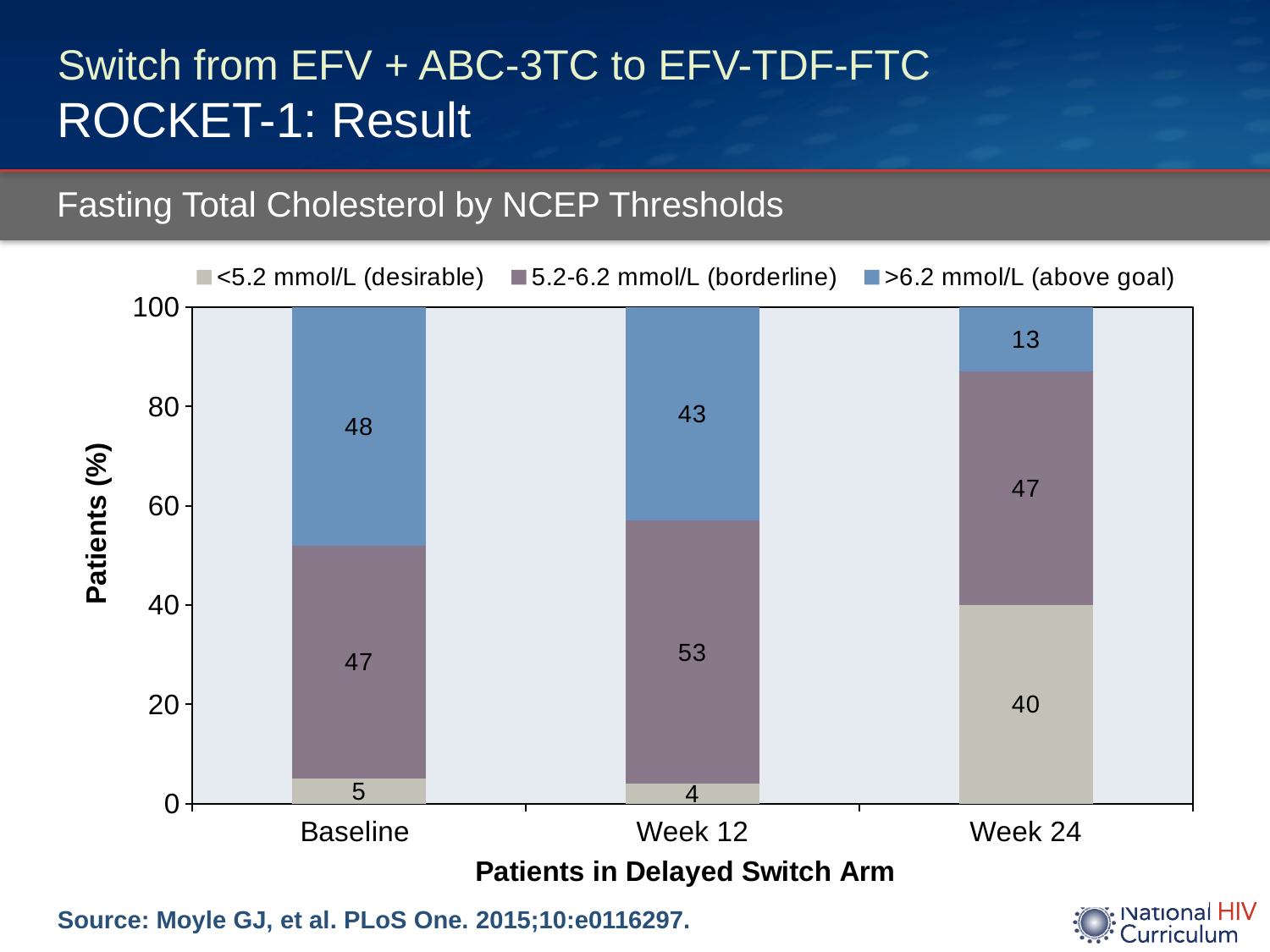
What is the label of the y axis? Patients (%) What kind of chart is shown? Stacked bar chart How many series does the legend list? 3 Does the >6.2 mmol/L (above goal) share rise or fall from Baseline to Week 24? Fall What percentage of patients had total cholesterol <5.2 mmol/L (desirable) at Week 24? 40 At which time point is the >6.2 mmol/L (above goal) share lowest? Week 24 Which is larger: the <5.2 mmol/L (desirable) share at Baseline or at Week 12? Baseline At which time point is the <5.2 mmol/L (desirable) share highest? Week 24 How many time points are shown on the x axis? 3 What percentage of patients had total cholesterol >6.2 mmol/L (above goal) at Baseline? 48 By how many percentage points did the >6.2 mmol/L (above goal) share fall from Baseline to Week 24? 35 What percentage of patients were in the 5.2-6.2 mmol/L (borderline) category at Week 12? 53